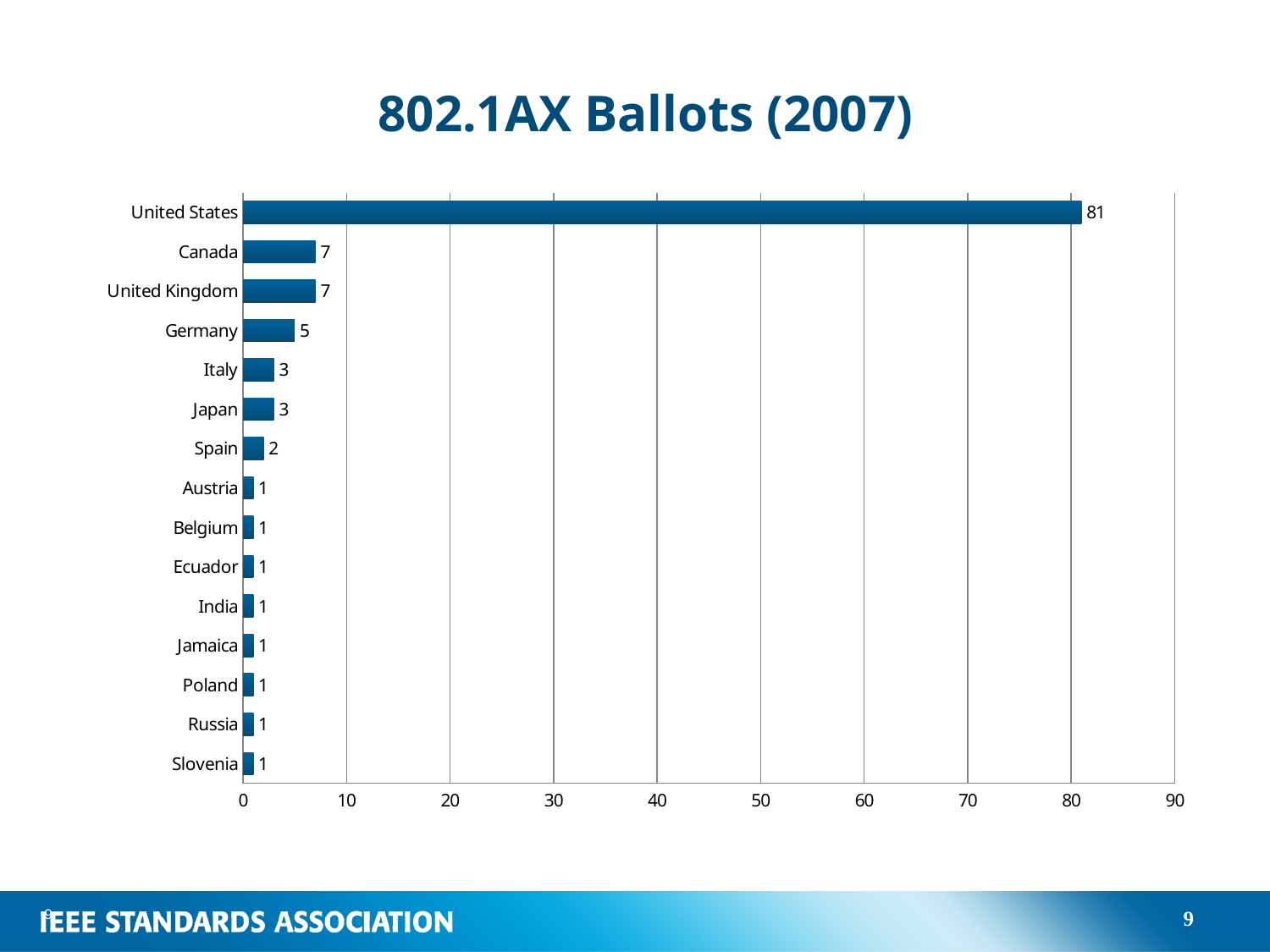
What is the title of the chart? 802.1AX Ballots (2007) How many countries are shown in the chart? 15 What is the value for Germany? 5 What kind of chart is shown on the slide? bar chart What is the difference between the values for Germany and Italy? 2 Is the value for the United States greater or less than 80? greater What is the value for Spain? 2 What is the difference between the values for the United States and Canada? 74 Which country has the highest number of ballots? United States Which is larger, the value for Canada or the value for Germany? Canada What is the value for the United States? 81 What is the value for Japan? 3